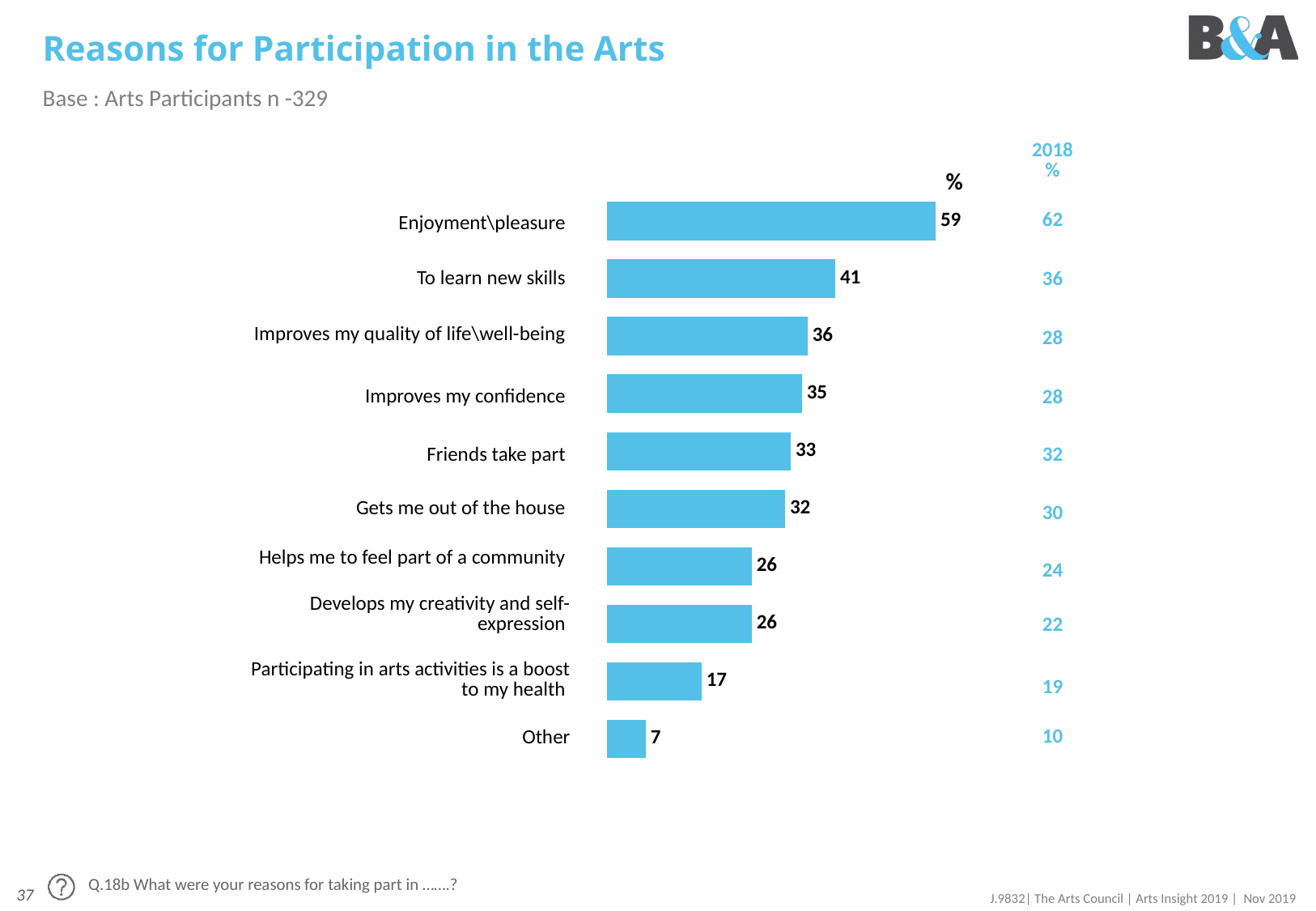
What is the difference between the values for Improves my quality of life\well-being and Improves my confidence? 1 What kind of chart is shown on the slide? Bar chart What is the value for Enjoyment\pleasure? 59 Which category has the highest value? Enjoyment\pleasure Which is larger, the value for Friends take part or the value for Helps me to feel part of a community? Friends take part What is the value for To learn new skills? 41 What is the 2018 % value shown for Gets me out of the house? 30 Which category has the lowest value? Other What is the title of the chart? Reasons for Participation in the Arts What is the value for Participating in arts activities is a boost to my health? 17 How many categories are shown in the chart? 10 What is the difference between the values for Enjoyment\pleasure and To learn new skills? 18